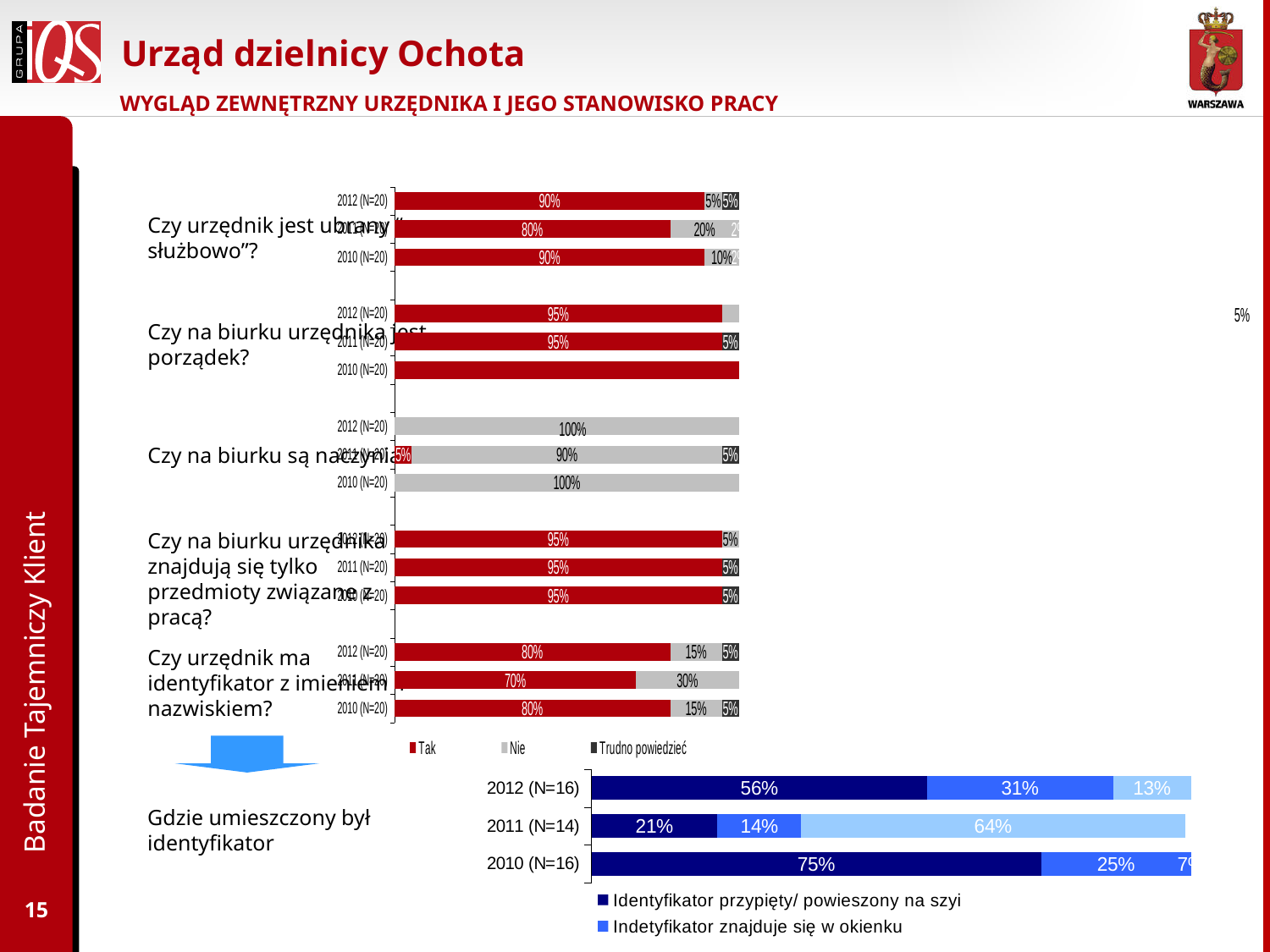
In the upper chart, for "Czy urzędnik ma identyfikator z imieniem i nazwiskiem?", by how many percentage points does the "Tak" value for 2012 (N=20) exceed that for 2011 (N=20)? 10 percentage points In the upper chart, for "Czy urzędnik jest ubrany służbowo?", what is the "Nie" value for 2011 (N=20)? 20% How many year categories are shown in the lower chart "Gdzie umieszczony był identyfikator"? 3 How many series does the legend of the upper chart list? 3 In the upper chart, for "Czy urzędnik jest ubrany służbowo?", which year has the larger "Tak" value: 2011 (N=20) or 2012 (N=20)? 2012 (N=20) In the upper chart, for "Czy na biurku są naczynia?", what is the "Nie" value for 2011 (N=20)? 90% What kind of chart is the lower chart titled "Gdzie umieszczony był identyfikator"? Stacked bar chart In the upper chart, for "Czy urzędnik ma identyfikator z imieniem i nazwiskiem?", what is the "Tak" value for 2011 (N=20)? 70% In the lower chart "Gdzie umieszczony był identyfikator", which year has the highest value for "Identyfikator przypięty/ powieszony na szyi"? 2010 (N=16) In the lower chart "Gdzie umieszczony był identyfikator", what is the value of "Identyfikator przypięty/ powieszony na szyi" for 2012 (N=16)? 56% In the upper chart, for the question "Czy urzędnik jest ubrany służbowo?", what is the "Tak" value for 2012 (N=20)? 90% In the lower chart "Gdzie umieszczony był identyfikator", what is the value of "Indetyfikator znajduje się w okienku" for 2011 (N=14)? 14%